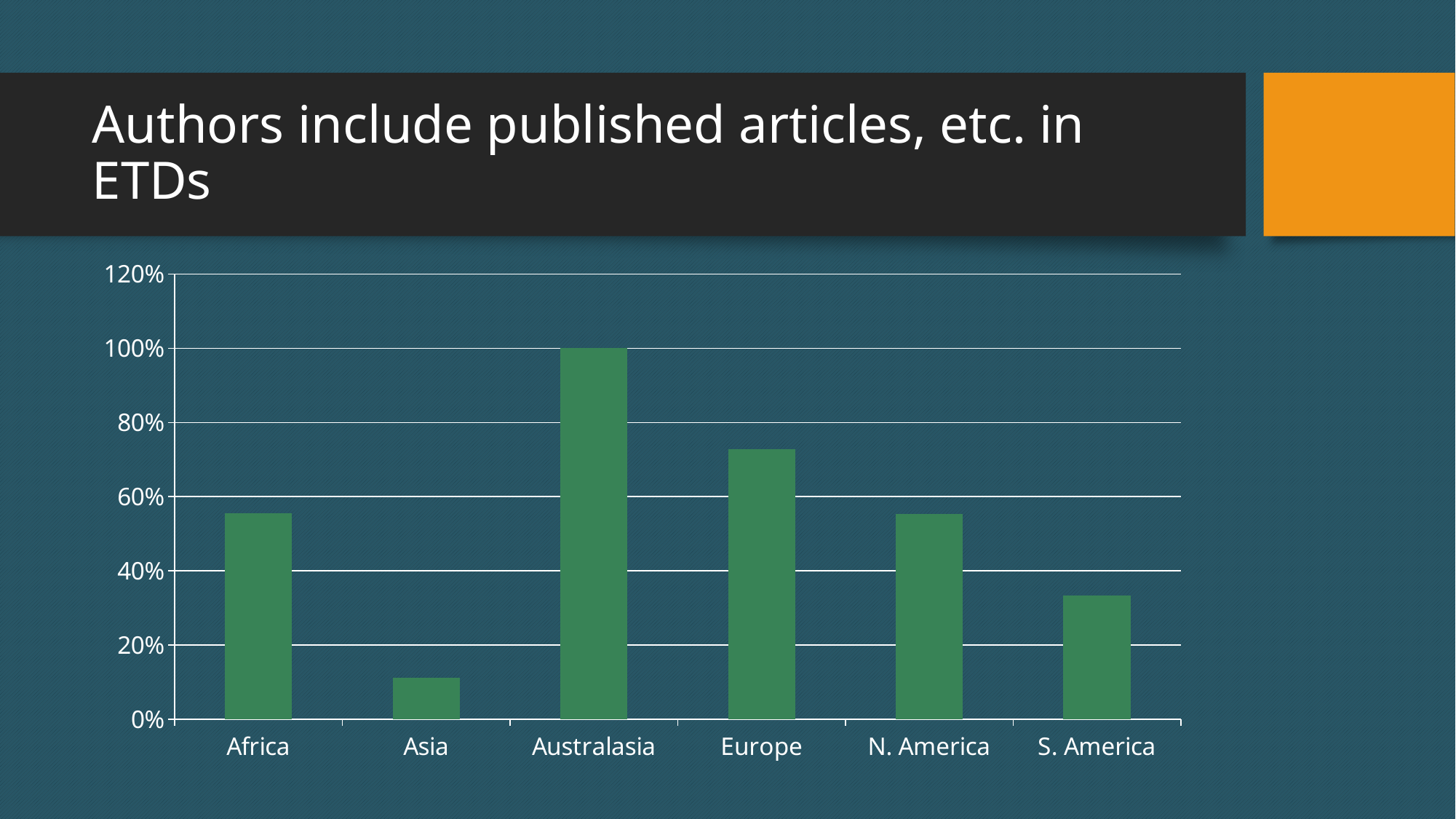
Is the value for S. America greater or less than 40%? less How many regions are shown on the x axis of the chart? 6 Is the value for Asia greater or less than 20%? less Which region has the lowest value in the chart? Asia Is the value for Europe greater or less than 60%? greater What is the value for Australasia? 100% What kind of chart is shown on the slide? bar chart Which has the larger value, Europe or N. America? Europe Which region has the highest value in the chart? Australasia Which has the larger value, Asia or S. America? S. America What is the title of the slide containing the chart? Authors include published articles, etc. in ETDs